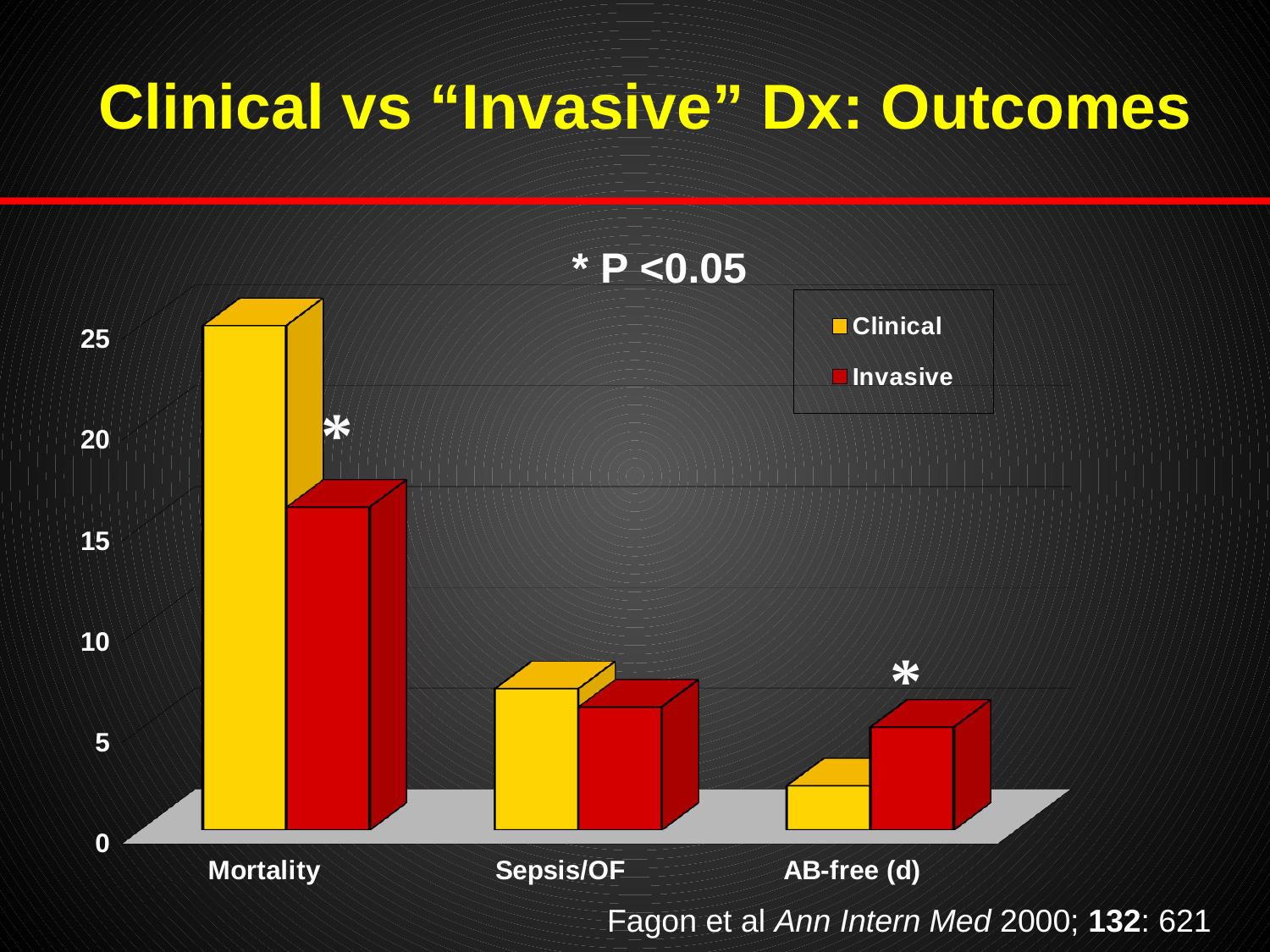
Is the Clinical value for AB-free (d) greater or less than 5? less For AB-free (d), which series has the larger value, Clinical or Invasive? Invasive What kind of chart is shown on the slide? bar chart Which category has the highest Invasive value? Mortality How many series does the chart's legend list? 2 Is the Invasive value for Mortality greater or less than 20? less Is the Clinical value for Mortality greater or less than 20? greater Which category has the lowest Clinical value? AB-free (d) For Mortality, which series has the larger value, Clinical or Invasive? Clinical How many categories are shown on the x axis of the chart? 3 Which category has the highest Clinical value? Mortality Which colour represents the Invasive series in the chart? red